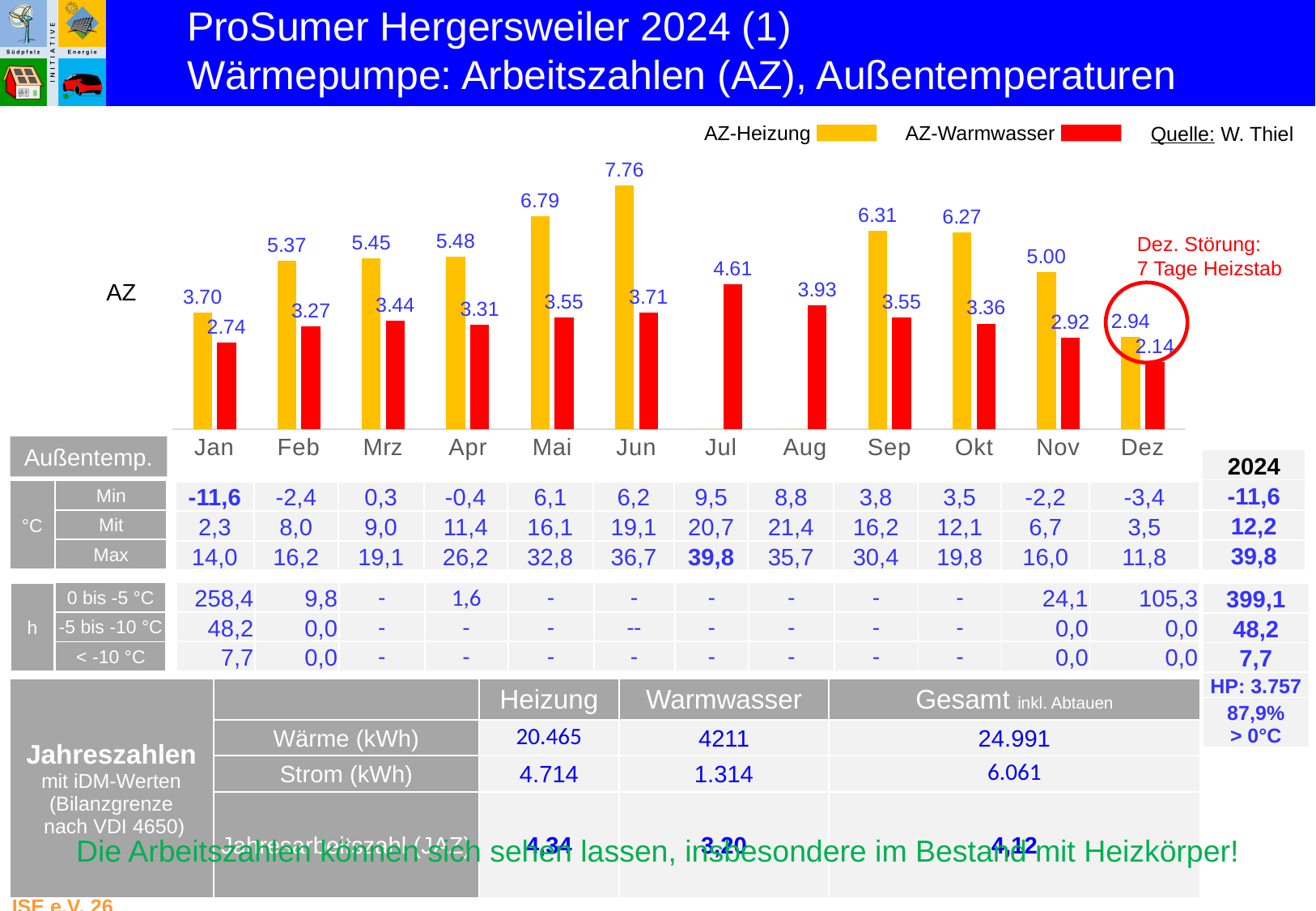
What is the difference between the AZ-Heizung and AZ-Warmwasser values in Jun? 4.05 Which month has the highest AZ-Heizung value? Jun What is the AZ-Heizung value for Jun? 7.76 Which month has the highest AZ-Warmwasser value? Jul What kind of chart is shown on the slide? Bar chart What is the AZ-Warmwasser value for Jul? 4.61 What is the AZ-Warmwasser value for Jan? 2.74 How many months are shown on the x axis of the chart? 12 Which month has the lowest AZ-Warmwasser value? Dez How many series does the chart legend list? 2 Which is larger, the AZ-Heizung value for Sep or for Okt? Sep